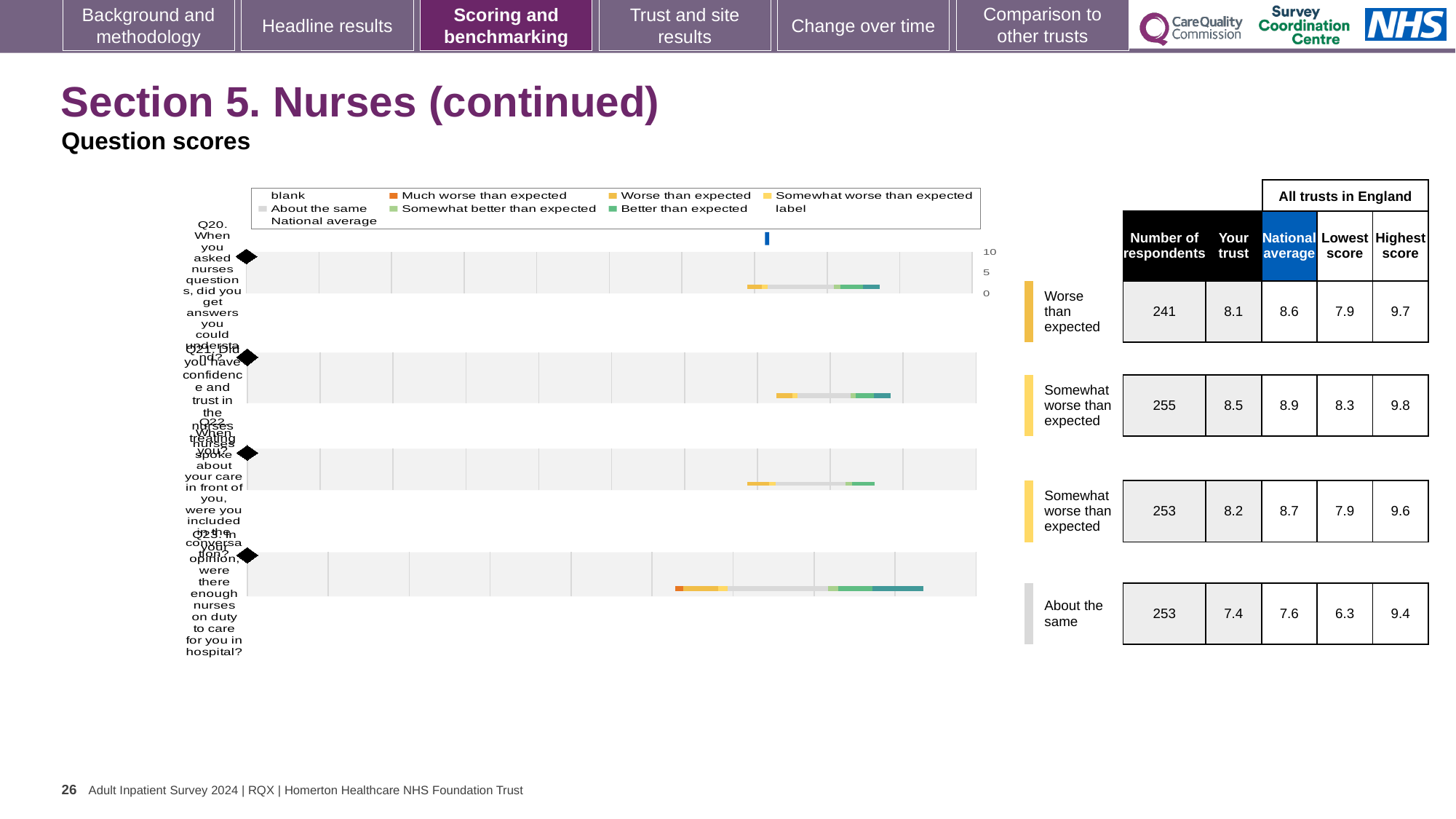
For Q22, which is larger: the 'Your trust' score or the national average? National average What is the lowest score among all trusts in England for Q23? 6.3 What is the national average score for Q23 (were there enough nurses on duty)? 7.6 How many respondents answered Q21 (confidence and trust in the nurses)? 255 Which question has the highest 'Your trust' score? Q21 For Q20, how much higher is the national average than the 'Your trust' score? 0.5 How many questions (rows) are plotted in the chart? 4 What is the 'Your trust' score for Q20 (did you get answers you could understand)? 8.1 What kind of chart is used to show the question scores? bar chart What is the highest score among all trusts in England for Q21? 9.8 Which question has the lowest 'Your trust' score? Q23 What benchmark category is shown for Q20? Worse than expected